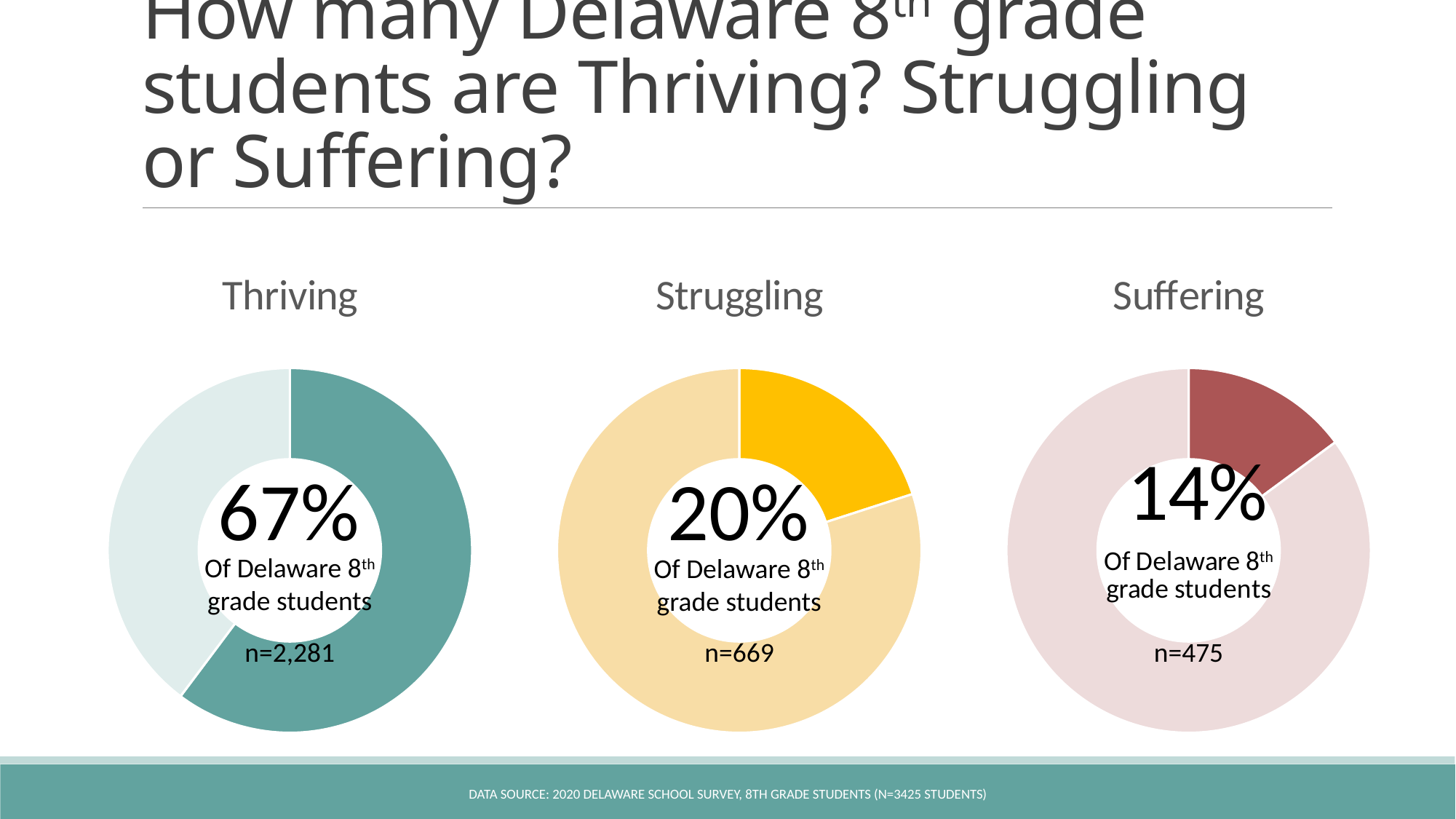
What is the difference in percentage points between the Thriving chart and the Struggling chart? 47 Across the three charts, which category has the highest percentage of students? Thriving What kind of chart is used for each of the three categories on the slide? Donut chart In the Suffering chart, what percentage of Delaware 8th grade students are suffering? 14% In the Thriving chart, what is the number of students (n) shown? n=2,281 Which is larger, the percentage in the Struggling chart or the percentage in the Suffering chart? Struggling How many charts are shown on the slide? 3 In the Struggling chart, what percentage of Delaware 8th grade students are struggling? 20% In the Suffering chart, what is the number of students (n) shown? n=475 In the Struggling chart, what is the number of students (n) shown? n=669 Across the three charts, which category has the lowest percentage of students? Suffering In the Thriving chart, what percentage of Delaware 8th grade students are thriving? 67%